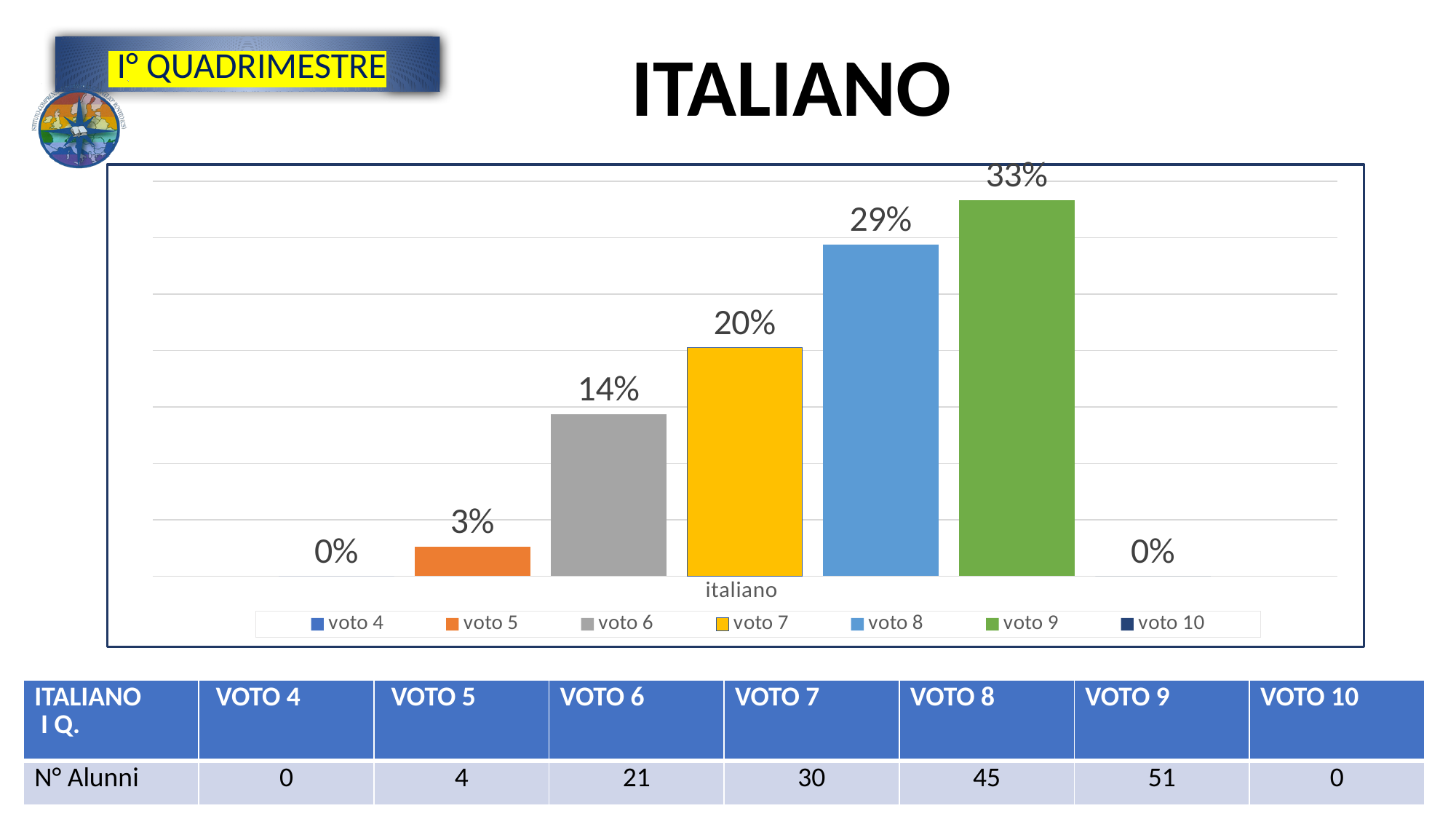
What kind of chart is shown on the slide? bar chart Which is larger, the value for voto 7 or the value for voto 8? voto 8 What is the difference between the values for voto 9 and voto 8? 4% Which series are shown with a value of 0%? voto 4 and voto 10 What is the value for voto 6? 14% Which series has the highest value? voto 9 What is the value for voto 5? 3% Do the values rise or fall from voto 5 to voto 9? rise How many series does the legend list? 7 What is the value for voto 9? 33% What is the difference between the values for voto 7 and voto 6? 6% What is the category label shown on the x axis of the chart? italiano